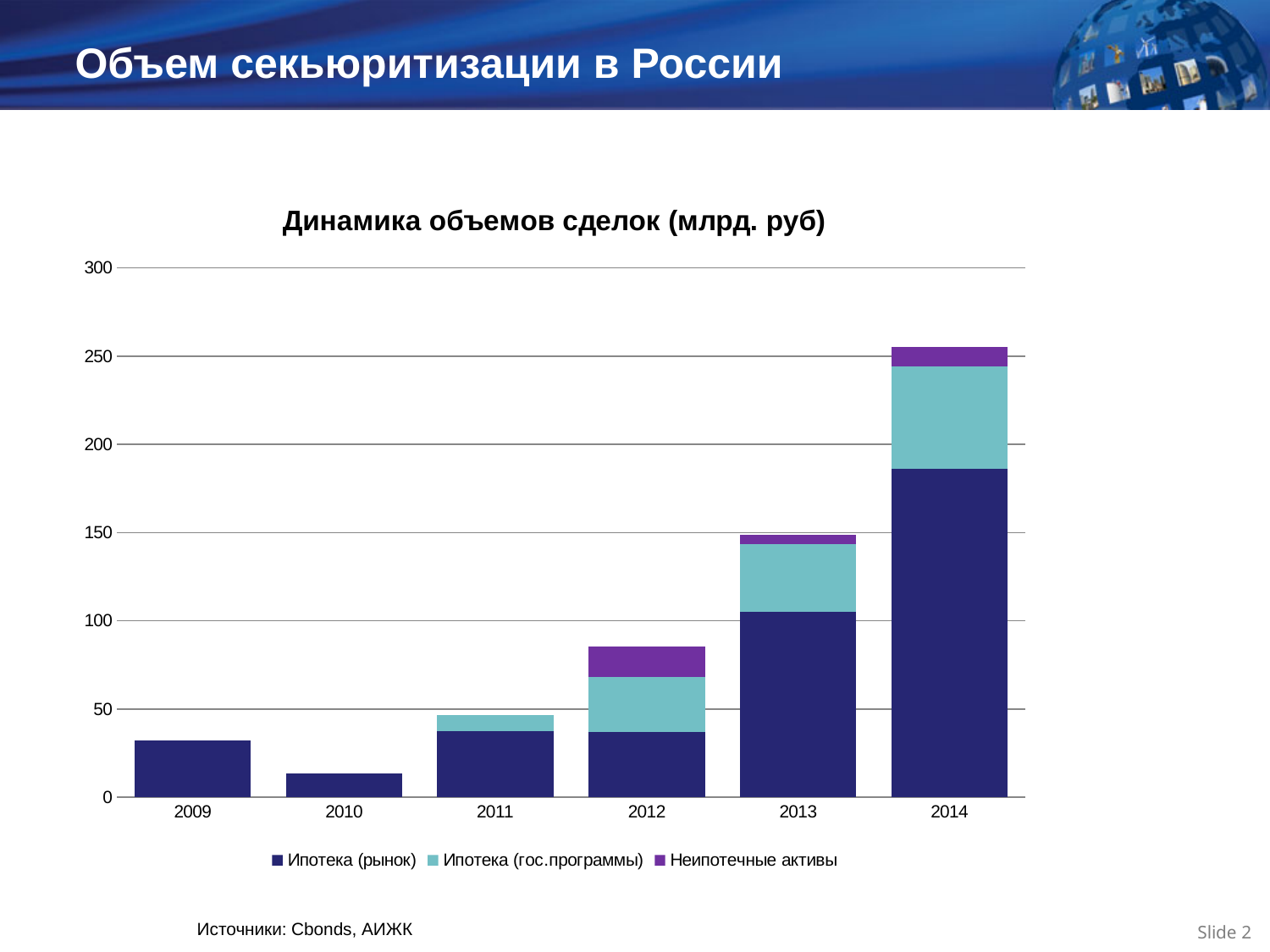
Which legend entry is shown in the darkest colour? Ипотека (рынок) Is the total bar for 2014 greater or less than 200? greater Which year has the lowest total bar? 2010 Which year has the highest total bar? 2014 How many series does the legend list? 3 Do the total bar heights generally rise or fall from 2010 to 2014? rise Is the total bar for 2010 greater or less than 50? less What kind of chart is shown on the slide? Stacked bar chart Which year has the larger total bar, 2012 or 2013? 2013 Is the total bar for 2013 greater or less than 100? greater What is the title of the chart? Динамика объемов сделок (млрд. руб) How many years are shown on the x axis? 6